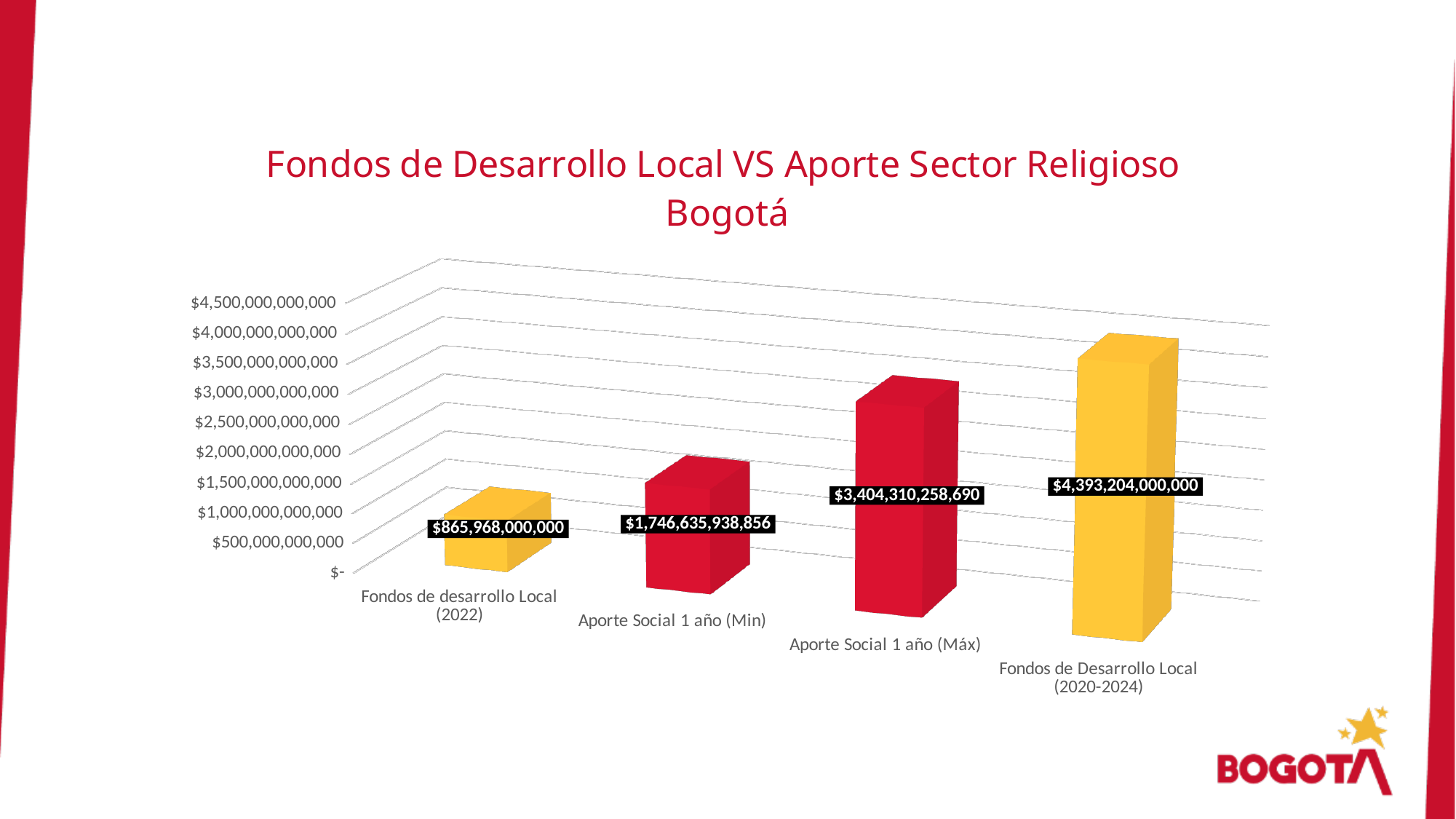
How many categories are shown in the chart? 4 What is the difference between Fondos de Desarrollo Local (2020-2024) and Aporte Social 1 año (Máx)? $988,893,741,310 Which category has the highest value? Fondos de Desarrollo Local (2020-2024) What kind of chart is shown on the slide? bar chart Which is larger, Aporte Social 1 año (Máx) or Aporte Social 1 año (Min)? Aporte Social 1 año (Máx) What is the value for Fondos de desarrollo Local (2022)? $865,968,000,000 Which category has the lowest value? Fondos de desarrollo Local (2022) What is the value for Fondos de Desarrollo Local (2020-2024)? $4,393,204,000,000 What is the difference between Aporte Social 1 año (Min) and Fondos de desarrollo Local (2022)? $880,667,938,856 What is the value for Aporte Social 1 año (Min)? $1,746,635,938,856 What is the value for Aporte Social 1 año (Máx)? $3,404,310,258,690 Is the value for Fondos de desarrollo Local (2022) greater or less than $1,000,000,000,000? less